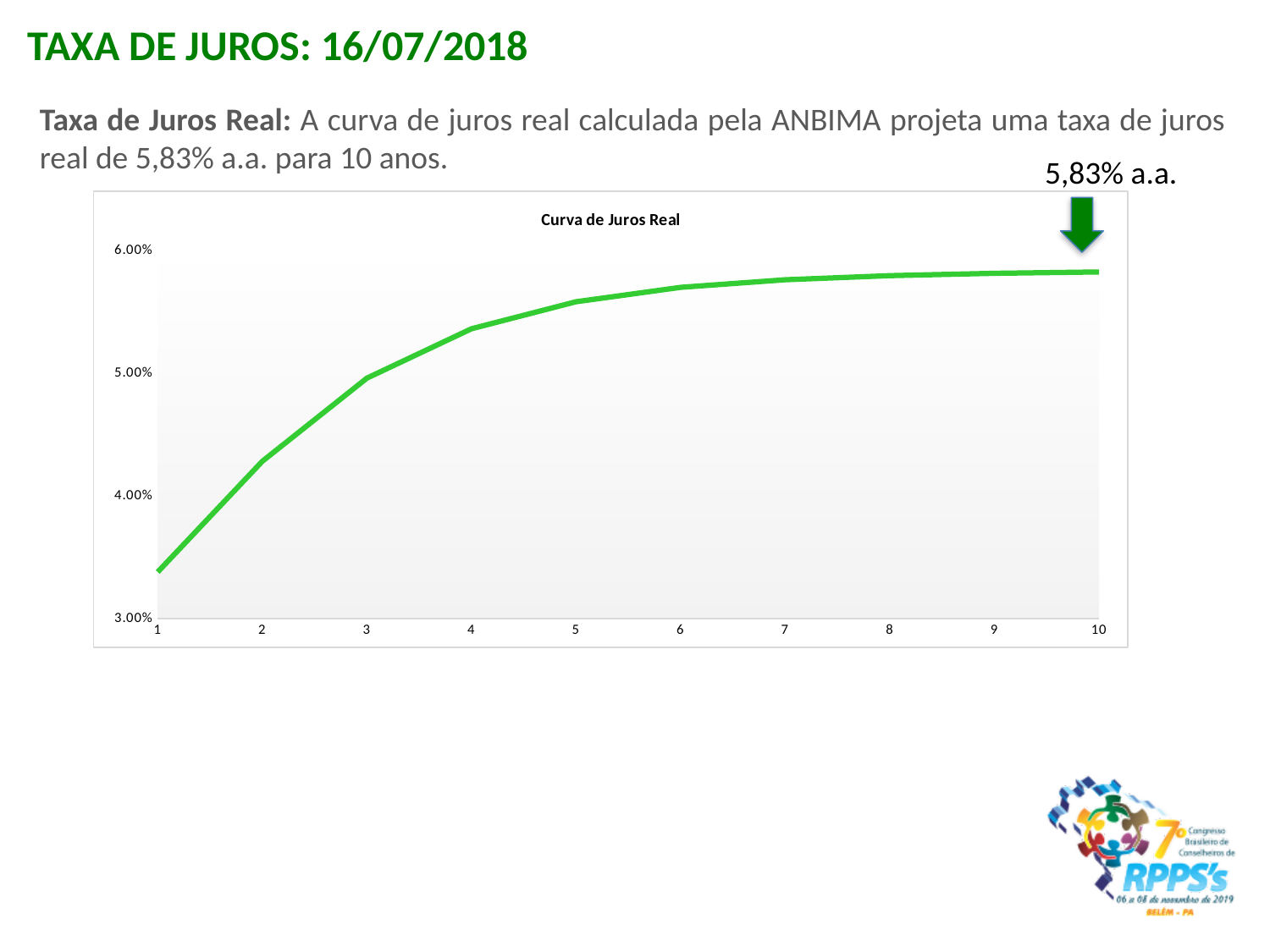
At which x-axis point is the curve highest? 10 Do the values rise or fall along the x axis from 1 to 10? rise How many points are plotted along the x axis of the chart? 10 What colour is the line in the chart? green What is the value of the curve at point 10, as annotated on the slide? 5,83% a.a. At which x-axis point is the curve lowest? 1 What kind of chart is shown on the slide? line chart What is the title of the chart? Curva de Juros Real Is the value at point 5 greater or less than 5.00%? greater Is the value at point 1 greater or less than 4.00%? less Which is larger, the value at point 2 or the value at point 8? point 8